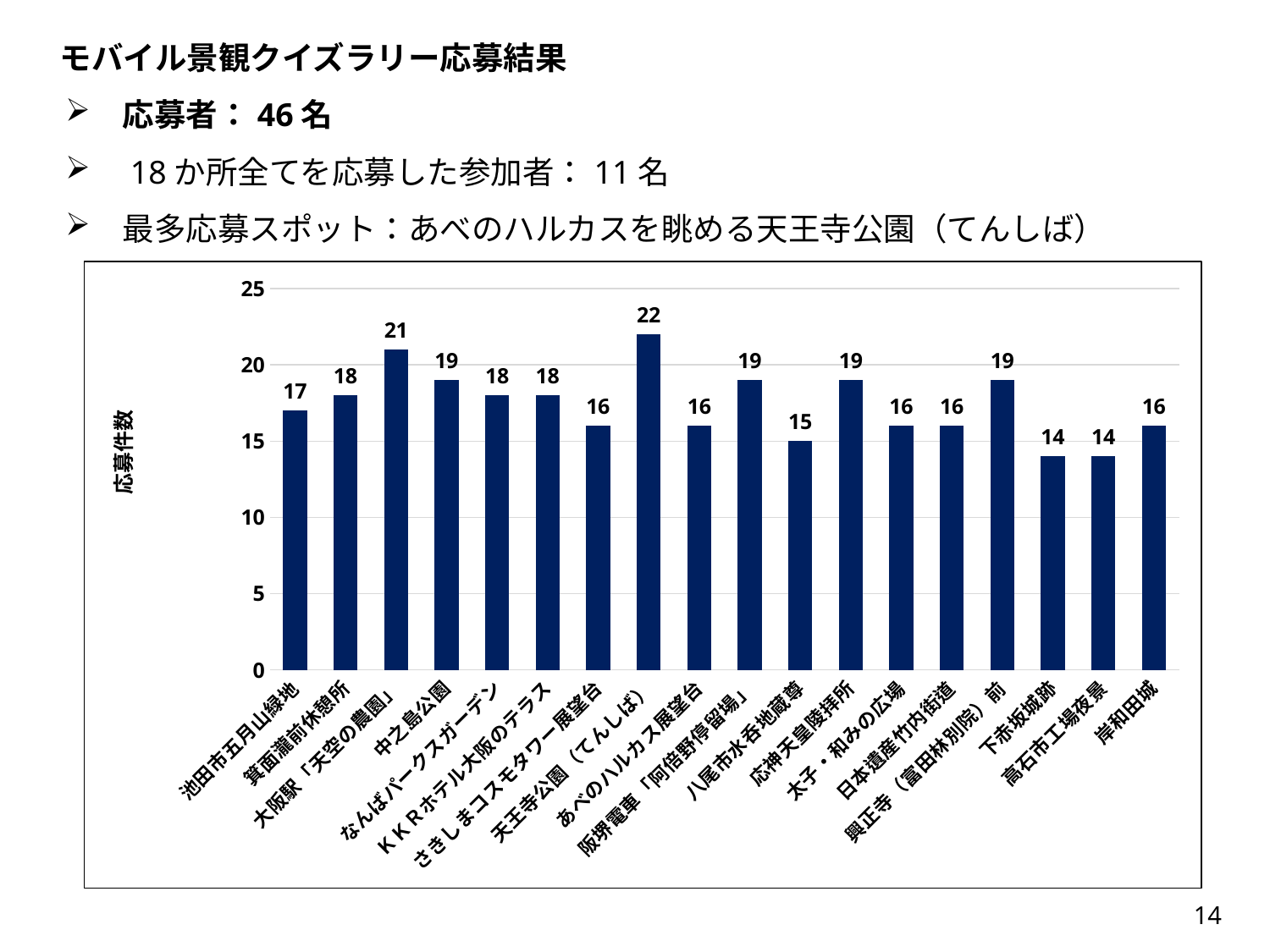
Which categories have the lowest value? 下赤坂城跡 and 高石市工場夜景 What kind of chart is shown on the slide? bar chart Which is larger, the value for 中之島公園 or the value for さきしまコスモタワー展望台? 中之島公園 What is the value for 天王寺公園（てんしば）? 22 What is the value for 岸和田城? 16 Is the value for 池田市五月山緑地 greater or less than 20? less What is the value for 八尾市水呑地蔵尊? 15 Which category has the highest value? 天王寺公園（てんしば） What is the difference between the values for 天王寺公園（てんしば） and 下赤坂城跡? 8 What is the label on the y axis of the chart? 応募件数 What is the value for 大阪駅「天空の農園」? 21 How many categories are shown on the x axis? 18